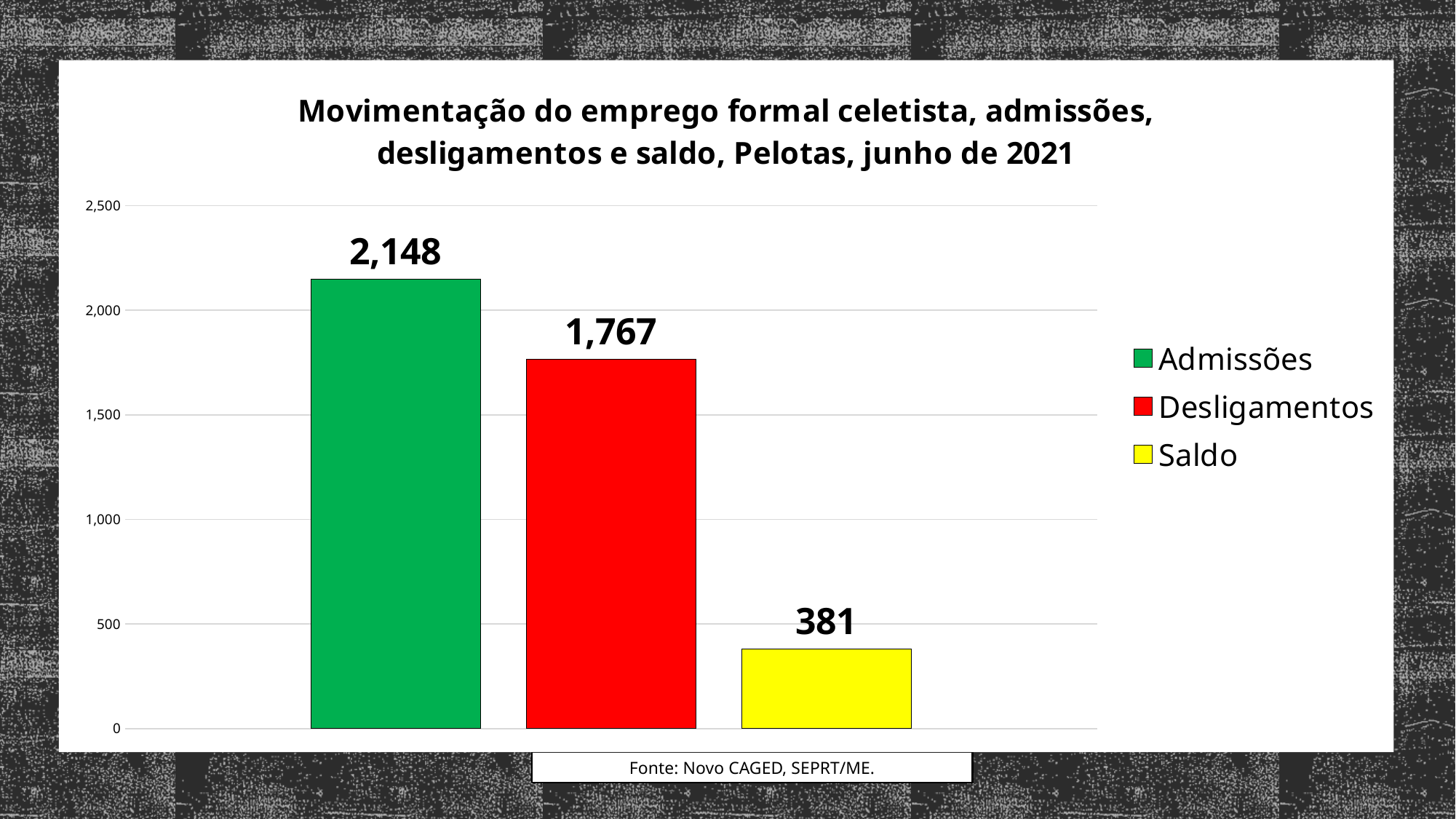
What is the difference between Admissões and Desligamentos? 381 Which is larger, Admissões or Desligamentos? Admissões Which series has the lowest value? Saldo What is the value for Desligamentos? 1,767 What is the difference between Desligamentos and Saldo? 1,386 What is the value for Admissões? 2,148 What is the value for Saldo? 381 Which series has the highest value? Admissões How many series does the legend list? 3 What kind of chart is shown on the slide? bar chart Is the value for Saldo greater or less than 500? less How many bars are plotted in the chart? 3